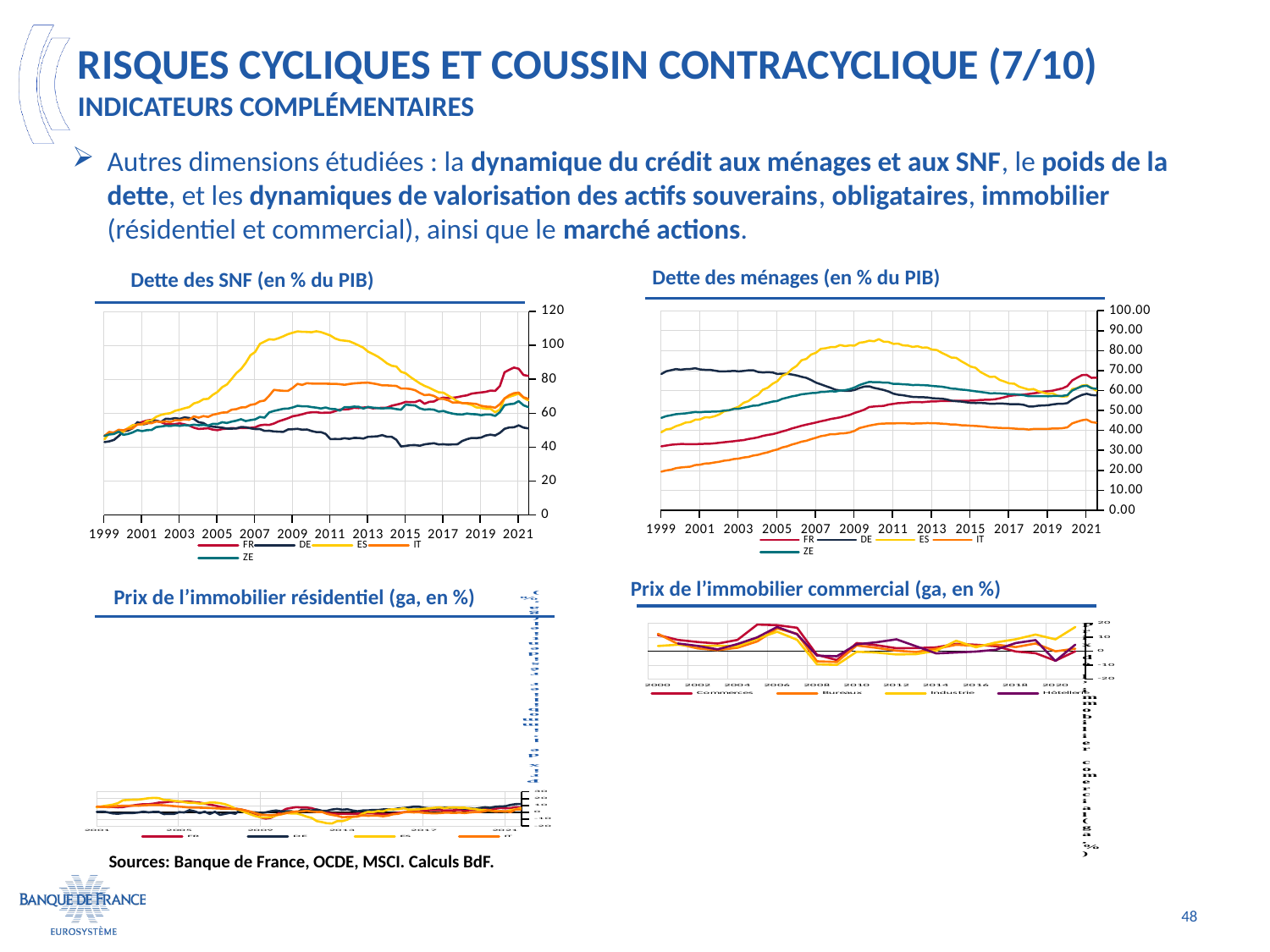
In the "Dette des ménages (en % du PIB)" chart, does the IT series rise or fall between 1999 and 2021? rise How many series does the legend of the "Dette des SNF (en % du PIB)" chart list? 5 In the "Dette des ménages (en % du PIB)" chart, which series is the lowest throughout the whole period? IT In the "Dette des ménages (en % du PIB)" chart, which is larger in 2021, FR or IT? FR In the "Dette des SNF (en % du PIB)" chart, is the peak value of ES around 2010 greater or less than 80? greater In the "Dette des SNF (en % du PIB)" chart, which series has the lowest value in 2015? DE How many series does the legend of the "Dette des ménages (en % du PIB)" chart list? 5 What kind of chart is the "Dette des SNF (en % du PIB)" chart? line chart In the "Dette des ménages (en % du PIB)" chart, is the peak value of ES greater or less than 70.00? greater What is the first year shown on the x axis of the "Dette des SNF (en % du PIB)" chart? 1999 In the "Dette des ménages (en % du PIB)" chart, is the value for IT in 1999 greater or less than 30.00? less In the "Dette des SNF (en % du PIB)" chart, which series reaches the highest value over the period? ES